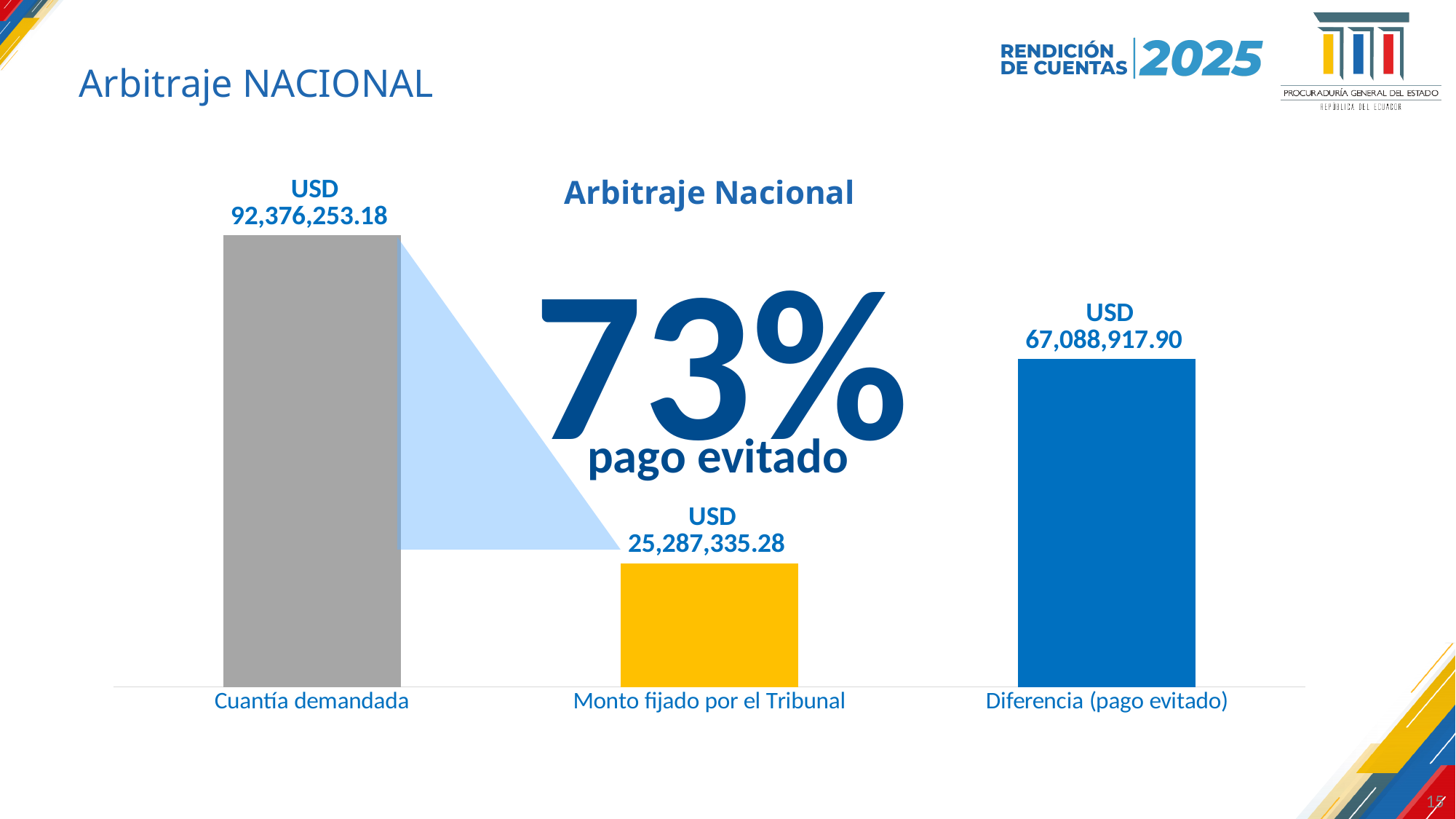
Which is larger, Cuantía demandada or Diferencia (pago evitado)? Cuantía demandada What is the difference between Cuantía demandada and Monto fijado por el Tribunal? USD 67,088,917.90 Which is larger, Diferencia (pago evitado) or Monto fijado por el Tribunal? Diferencia (pago evitado) Which category has the highest value? Cuantía demandada What percentage of payment avoided (pago evitado) is highlighted on the chart? 73% What kind of chart is shown on the slide? Bar chart What is the title of the chart? Arbitraje Nacional What is the value for Monto fijado por el Tribunal? USD 25,287,335.28 What is the value for Cuantía demandada? USD 92,376,253.18 What is the value for Diferencia (pago evitado)? USD 67,088,917.90 How many categories are shown in the chart? 3 Which category has the lowest value? Monto fijado por el Tribunal